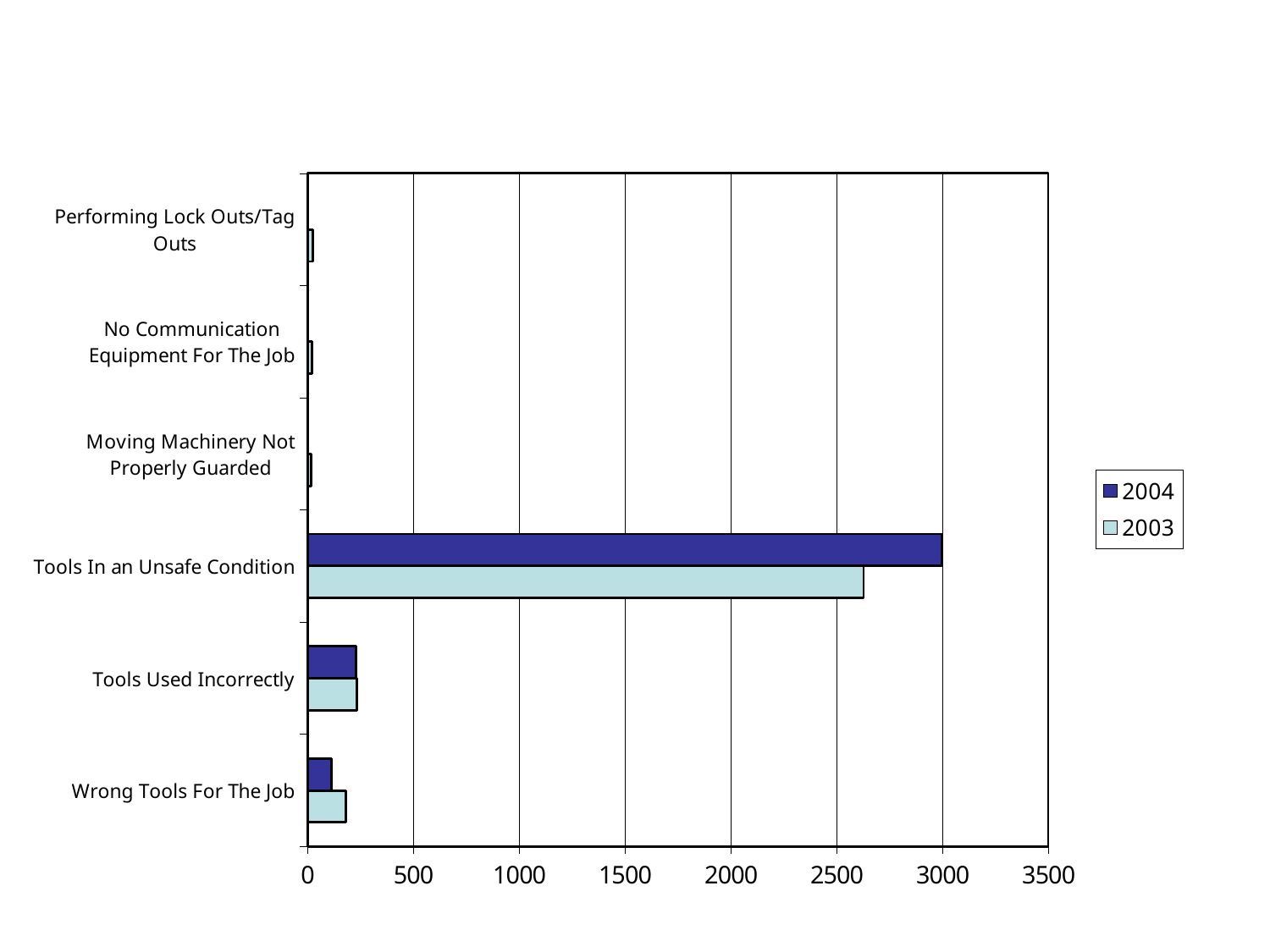
Which category has the highest value for 2004? Tools In an Unsafe Condition How many series does the legend list? 2 Is the 2004 value for Tools Used Incorrectly greater or less than 500? less What are the two entries listed in the legend? 2004 and 2003 Is the 2004 value for Tools In an Unsafe Condition greater or less than 2500? greater For Tools In an Unsafe Condition, which year has the larger value, 2004 or 2003? 2004 How many categories are shown on the chart? 6 For Wrong Tools For The Job, which year has the larger value, 2004 or 2003? 2003 Which category has the highest value for 2003? Tools In an Unsafe Condition What kind of chart is shown on the slide? Bar chart Is the 2003 value for Wrong Tools For The Job greater or less than 500? less